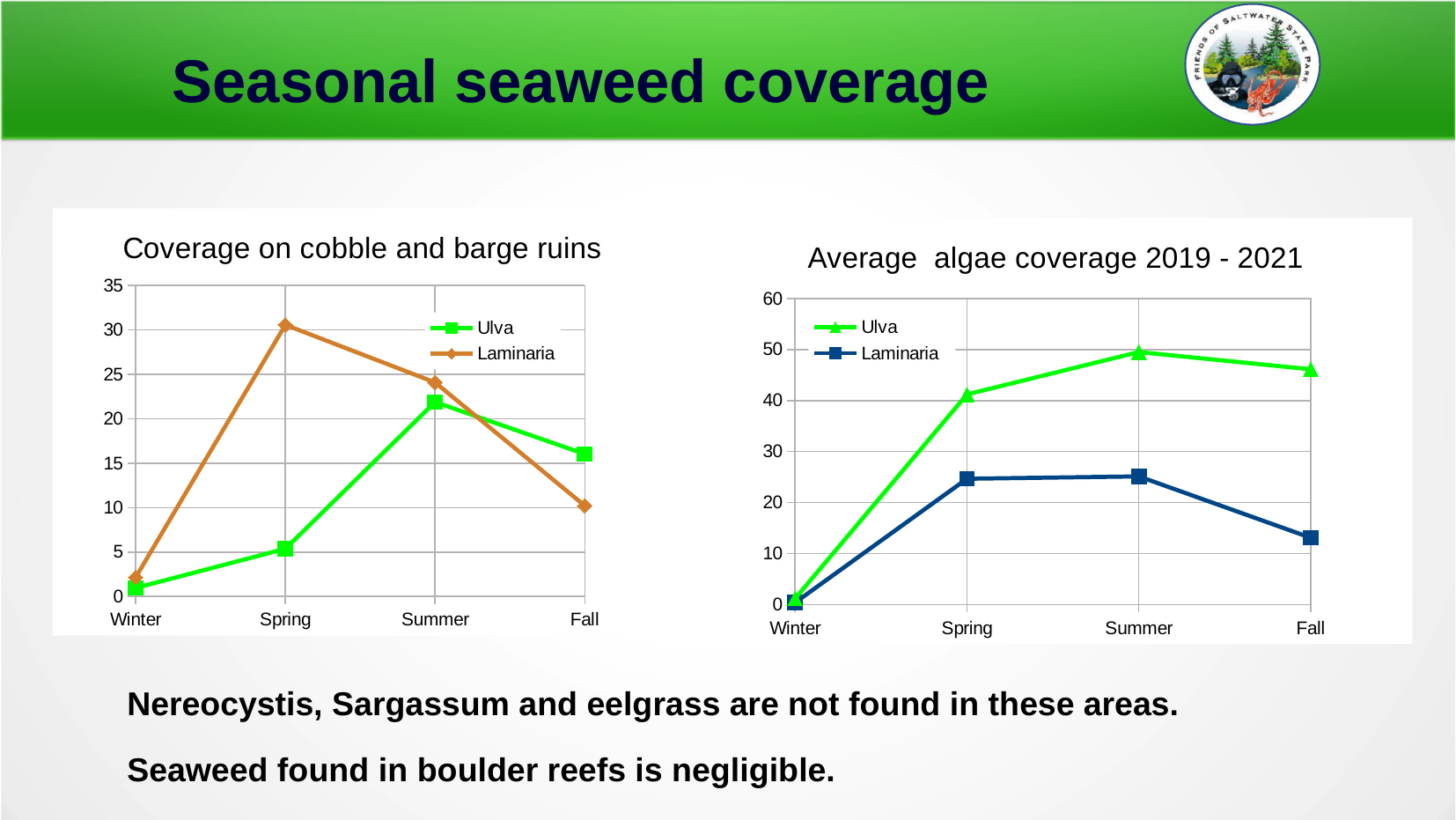
In the 'Coverage on cobble and barge ruins' chart, in which season is Laminaria coverage highest? Spring In the 'Coverage on cobble and barge ruins' chart, which series has the larger value in Spring, Ulva or Laminaria? Laminaria How many series does the legend of the 'Coverage on cobble and barge ruins' chart list? 2 What kind of chart is the 'Coverage on cobble and barge ruins' chart? line chart In the 'Average algae coverage 2019 - 2021' chart, which series has the larger value in Summer, Ulva or Laminaria? Ulva In the 'Coverage on cobble and barge ruins' chart, is the Laminaria value for Spring greater or less than 25? greater In the 'Average algae coverage 2019 - 2021' chart, in which season is Ulva coverage highest? Summer How many seasons are shown on the x axis of the 'Coverage on cobble and barge ruins' chart? 4 Which two series are listed in the legend of the 'Average algae coverage 2019 - 2021' chart? Ulva and Laminaria In the 'Coverage on cobble and barge ruins' chart, is the Ulva value for Summer greater or less than 20? greater In the 'Average algae coverage 2019 - 2021' chart, is the Laminaria value for Fall greater or less than 20? less In the 'Coverage on cobble and barge ruins' chart, does Ulva coverage rise or fall from Winter to Summer? rise